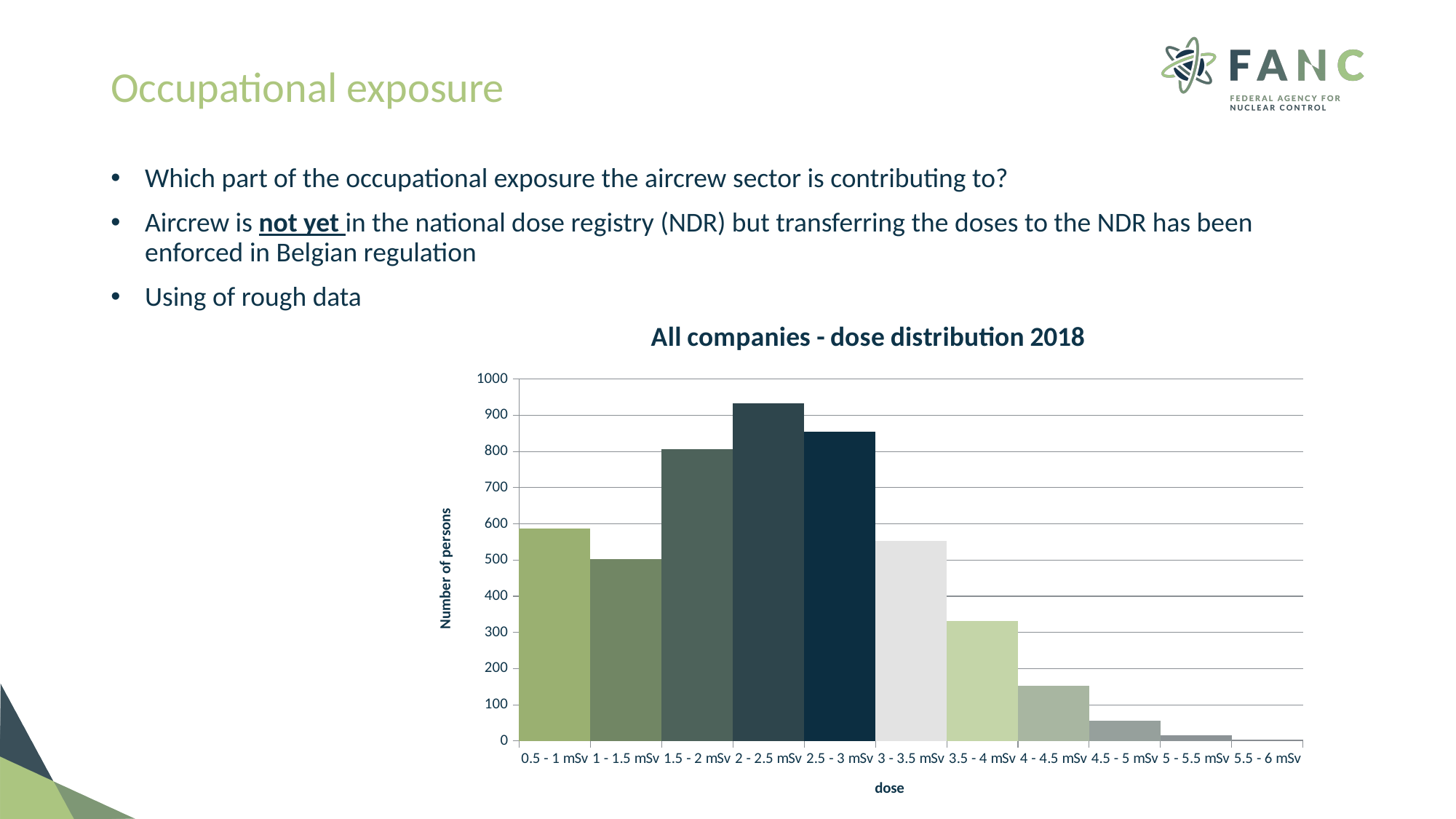
Which dose category has the lowest number of persons? 5.5 - 6 mSv Which has more persons: the 2.5 - 3 mSv category or the 3 - 3.5 mSv category? 2.5 - 3 mSv Is the value for 0.5 - 1 mSv greater or less than 500? greater Which has more persons: the 1.5 - 2 mSv category or the 1 - 1.5 mSv category? 1.5 - 2 mSv What kind of chart is shown under the title 'All companies - dose distribution 2018'? bar chart What is the label of the vertical axis of the chart? Number of persons Is the value for 4 - 4.5 mSv greater or less than 100? greater How many dose categories are shown on the x axis of the chart? 11 Is the value for 2 - 2.5 mSv greater or less than 900? greater Do the values rise or fall along the x axis from the 2 - 2.5 mSv category to the 5.5 - 6 mSv category? fall Which dose category has the highest number of persons? 2 - 2.5 mSv